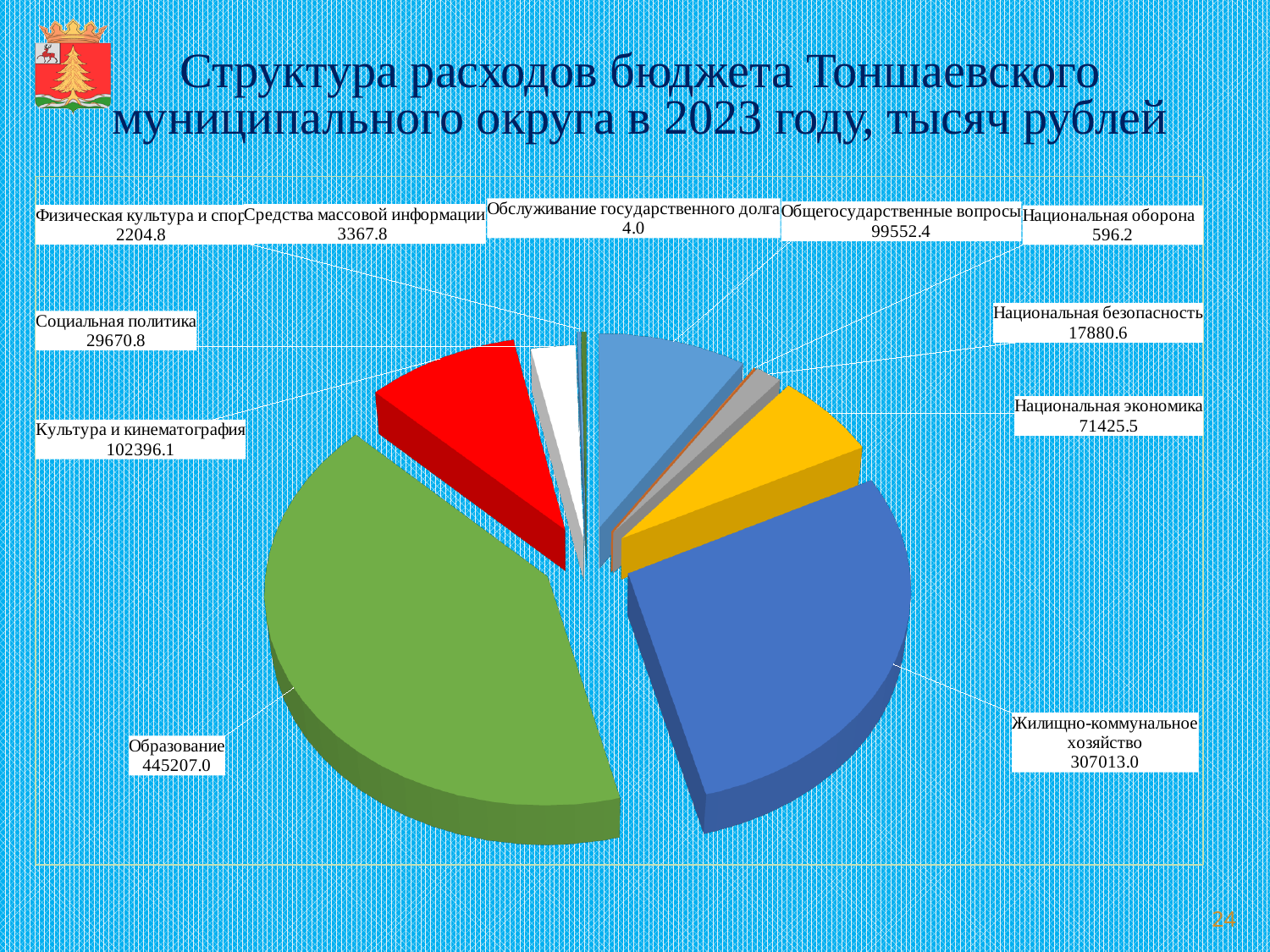
How many categories are shown in the pie chart? 11 Which is larger: Национальная экономика or Социальная политика? Национальная экономика What is the value for Жилищно-коммунальное хозяйство? 307013.0 What is the value for Обслуживание государственного долга? 4.0 What is the value for Национальная безопасность? 17880.6 What colour is the slice for Образование? Green Which category has the largest value? Образование What type of chart is shown on the slide? Pie chart Which category has the smallest value? Обслуживание государственного долга What is the value for Образование? 445207.0 What is the difference between the values for Культура и кинематография and Общегосударственные вопросы? 2843.7 What is the difference between the values for Образование and Жилищно-коммунальное хозяйство? 138194.0